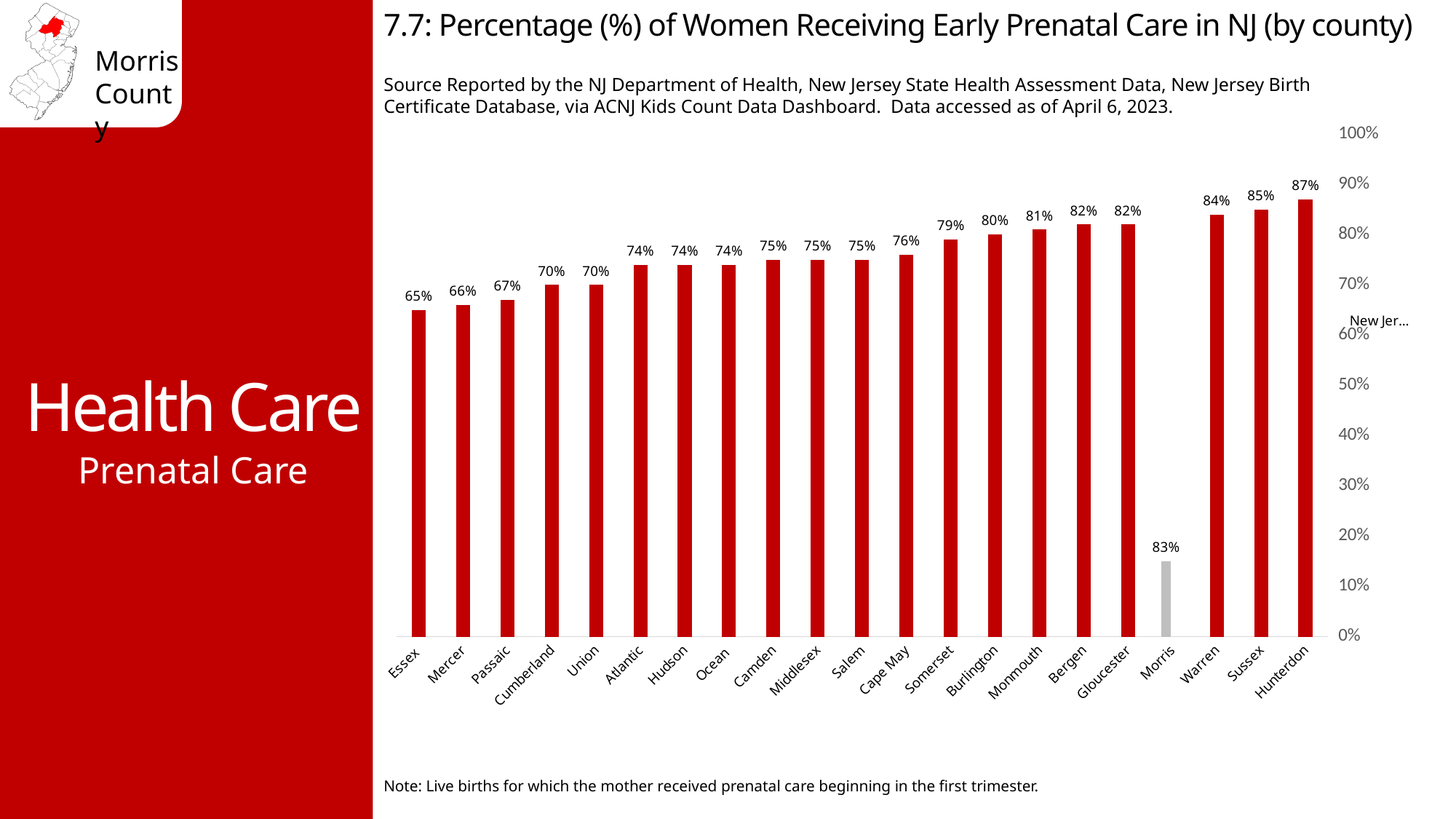
Which county's bar is colored gray instead of red? Morris What is the value shown for Hunterdon county? 87% What is the difference in percentage points between Sussex and Mercer? 19 percentage points Which county has the highest percentage of women receiving early prenatal care? Hunterdon What is the difference in percentage points between Hunterdon and Essex? 22 percentage points What is the value labeled for Morris county? 83% How many counties are shown on the x axis of the chart? 21 What kind of chart is used on this slide? Bar chart What is the value shown for Somerset county? 79% Which has a higher value, Bergen or Cumberland? Bergen Is the value for Warren greater or less than 80%? greater What percentage of women received early prenatal care in Essex county? 65%